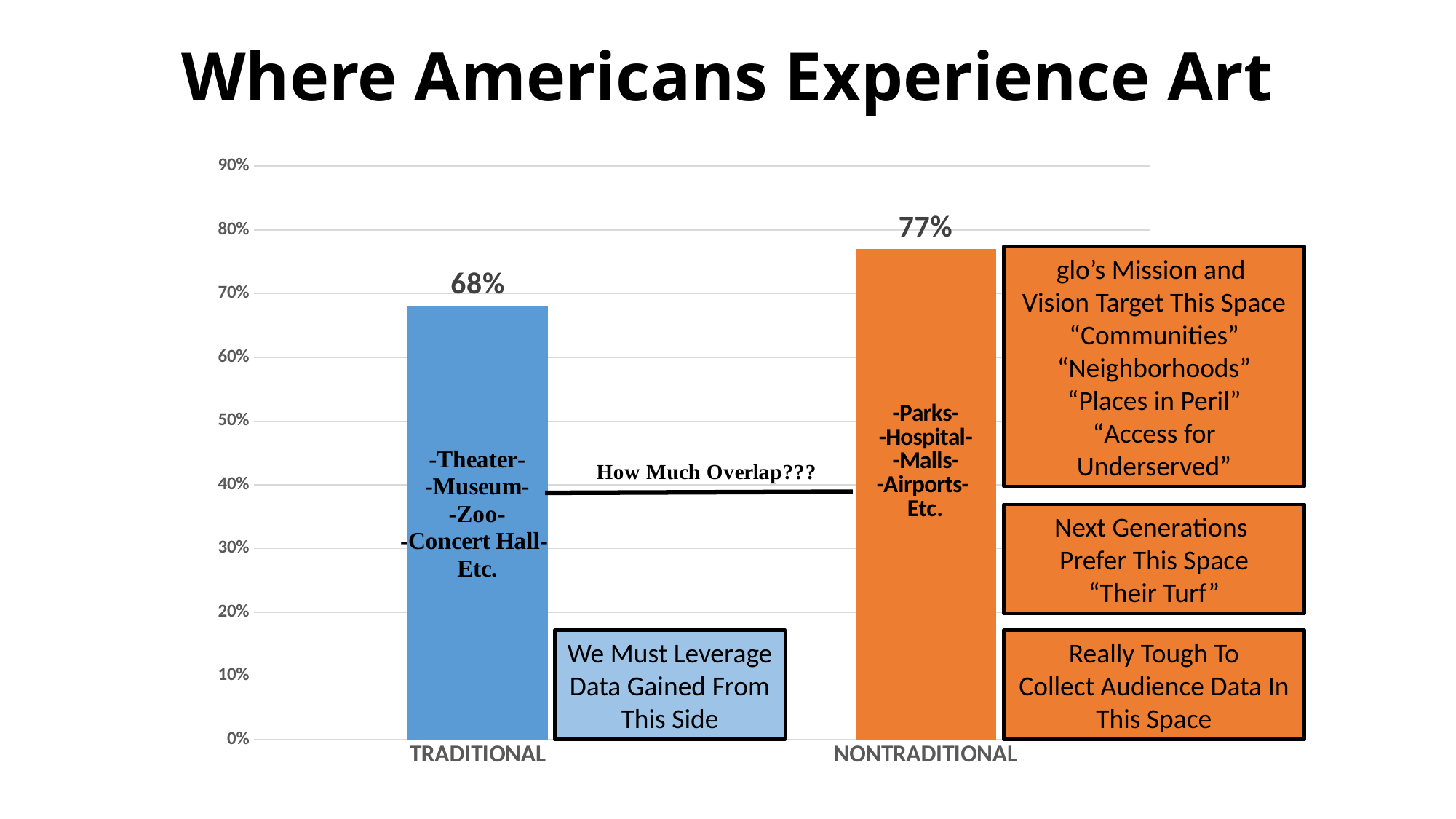
Which is larger, the value for TRADITIONAL or NONTRADITIONAL? NONTRADITIONAL What colour is the NONTRADITIONAL bar? orange Which category has the highest value? NONTRADITIONAL What is the title of the slide? Where Americans Experience Art Is the value for NONTRADITIONAL greater or less than 70%? greater What kind of chart is shown on the slide? bar chart Which category has the lowest value? TRADITIONAL What is the difference between the NONTRADITIONAL and TRADITIONAL values? 9% How many categories are shown on the chart? 2 What is the value for TRADITIONAL? 68% What is the value for NONTRADITIONAL? 77% Is the value for TRADITIONAL greater or less than 70%? less